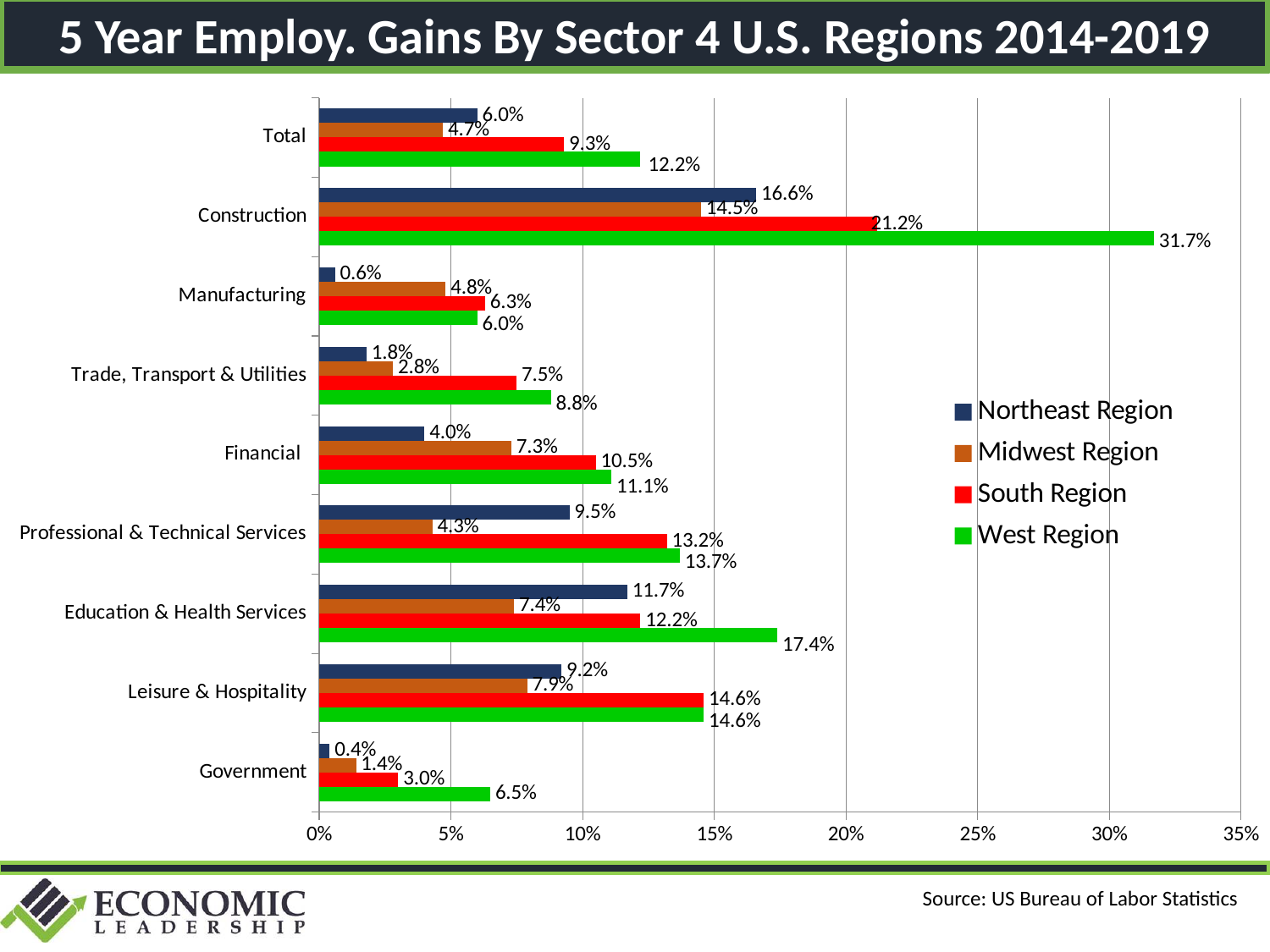
How many sector categories are shown on the chart? 9 Is the South Region value for Construction greater or less than 20%? greater What is the Northeast Region value for Manufacturing? 0.6% How many series does the legend list? 4 What is the South Region value for Financial? 10.5% Which is larger for Professional & Technical Services: the Northeast Region value or the Midwest Region value? Northeast Region Which sector has the lowest Northeast Region value? Government What is the difference between the West Region and Northeast Region values for Education & Health Services? 5.7% What is the West Region value for Construction? 31.7% Which sector has the highest West Region value? Construction What is the Midwest Region value for Government? 1.4% What kind of chart is shown on the slide? Bar chart